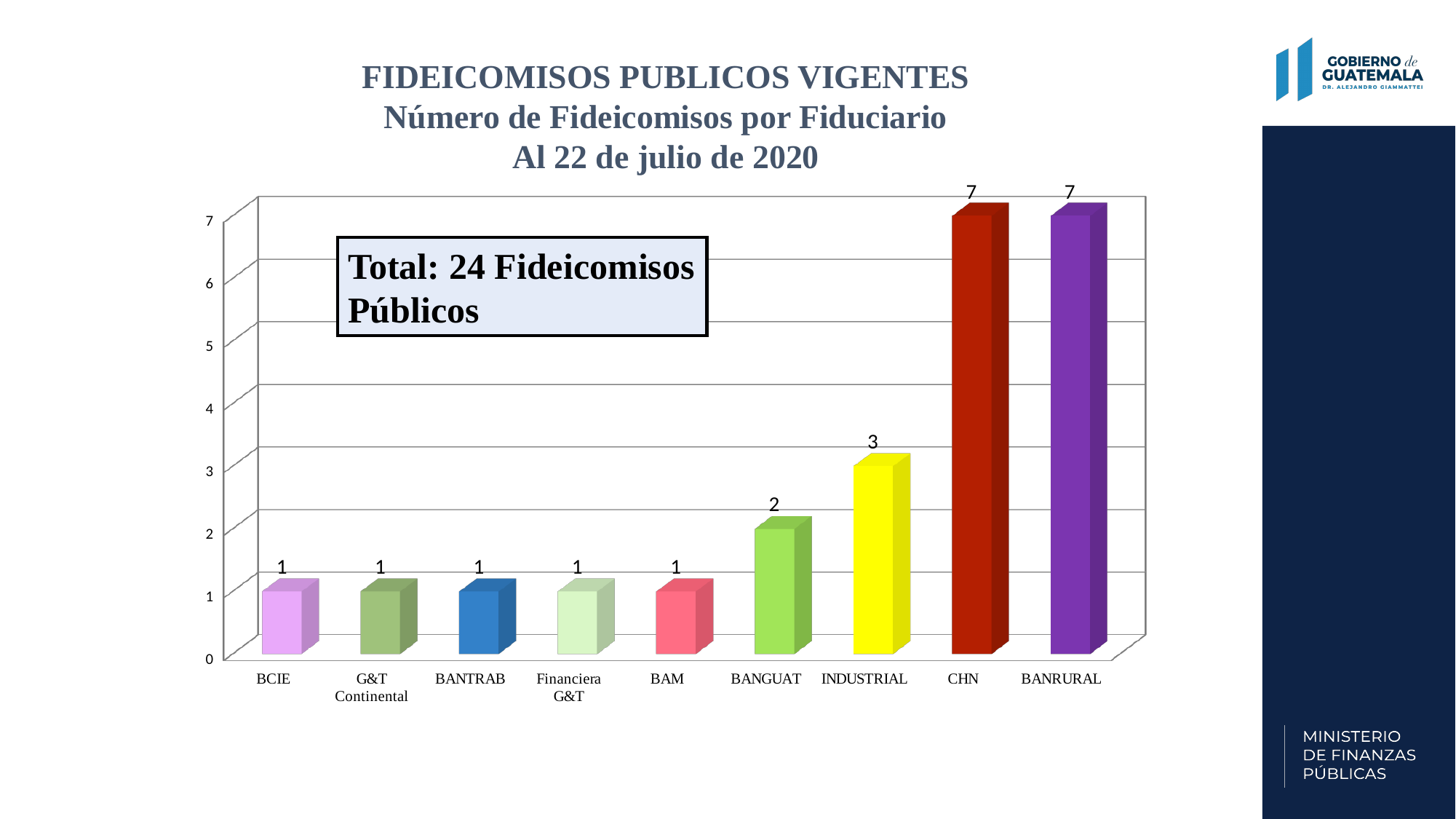
Do the values rise or fall from left to right along the x axis? rise What is the difference between the values for CHN and INDUSTRIAL? 4 What total is stated in the text box on the chart? Total: 24 Fideicomisos Públicos Which categories have the highest value? CHN and BANRURAL What is the value for BANGUAT? 2 What kind of chart is shown on the slide? bar chart What is the value for BANTRAB? 1 Is the value for BANRURAL greater or less than 5? greater What is the value for INDUSTRIAL? 3 What is the value for CHN? 7 Which is larger, the value for BANGUAT or the value for BAM? BANGUAT How many categories are shown on the x axis? 9